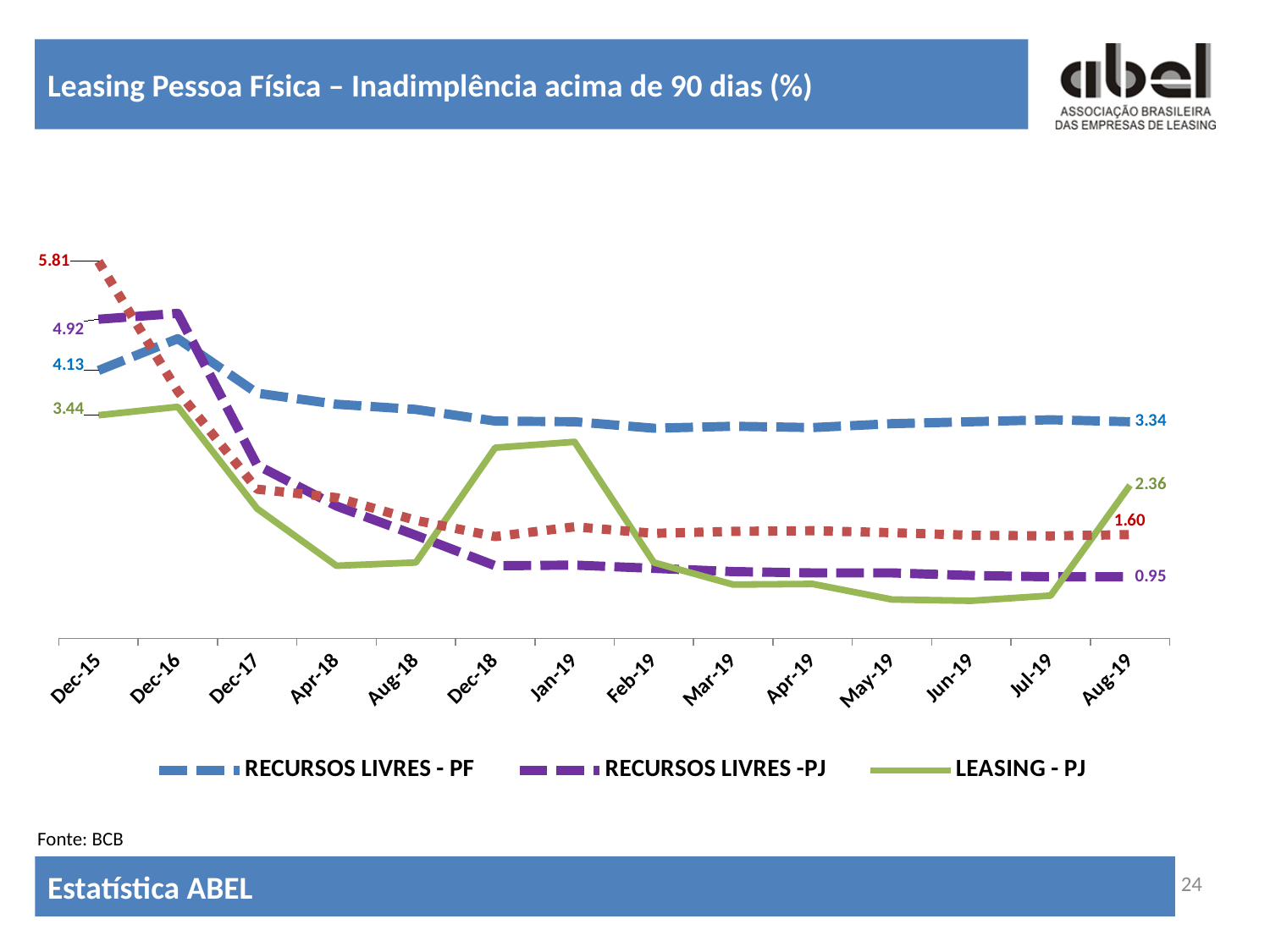
How many dates are shown on the x axis? 14 Does the RECURSOS LIVRES -PJ line rise or fall overall from Dec-15 to Aug-19? Fall What is the value of LEASING - PJ at Dec-15? 3.44 By how much did RECURSOS LIVRES -PJ fall from Dec-15 (4.92) to Aug-19 (0.95)? 3.97 What kind of chart is shown on the slide? Line chart What is the value of RECURSOS LIVRES -PJ at Aug-19? 0.95 What is the value of RECURSOS LIVRES - PF at Dec-15? 4.13 What is the value of RECURSOS LIVRES - PF at Aug-19? 3.34 What is the difference between the LEASING - PJ values at Dec-15 and Aug-19? 1.08 What is the value of LEASING - PJ at Aug-19? 2.36 At Aug-19, which is higher: RECURSOS LIVRES - PF or LEASING - PJ? RECURSOS LIVRES - PF How many series does the legend list? 3